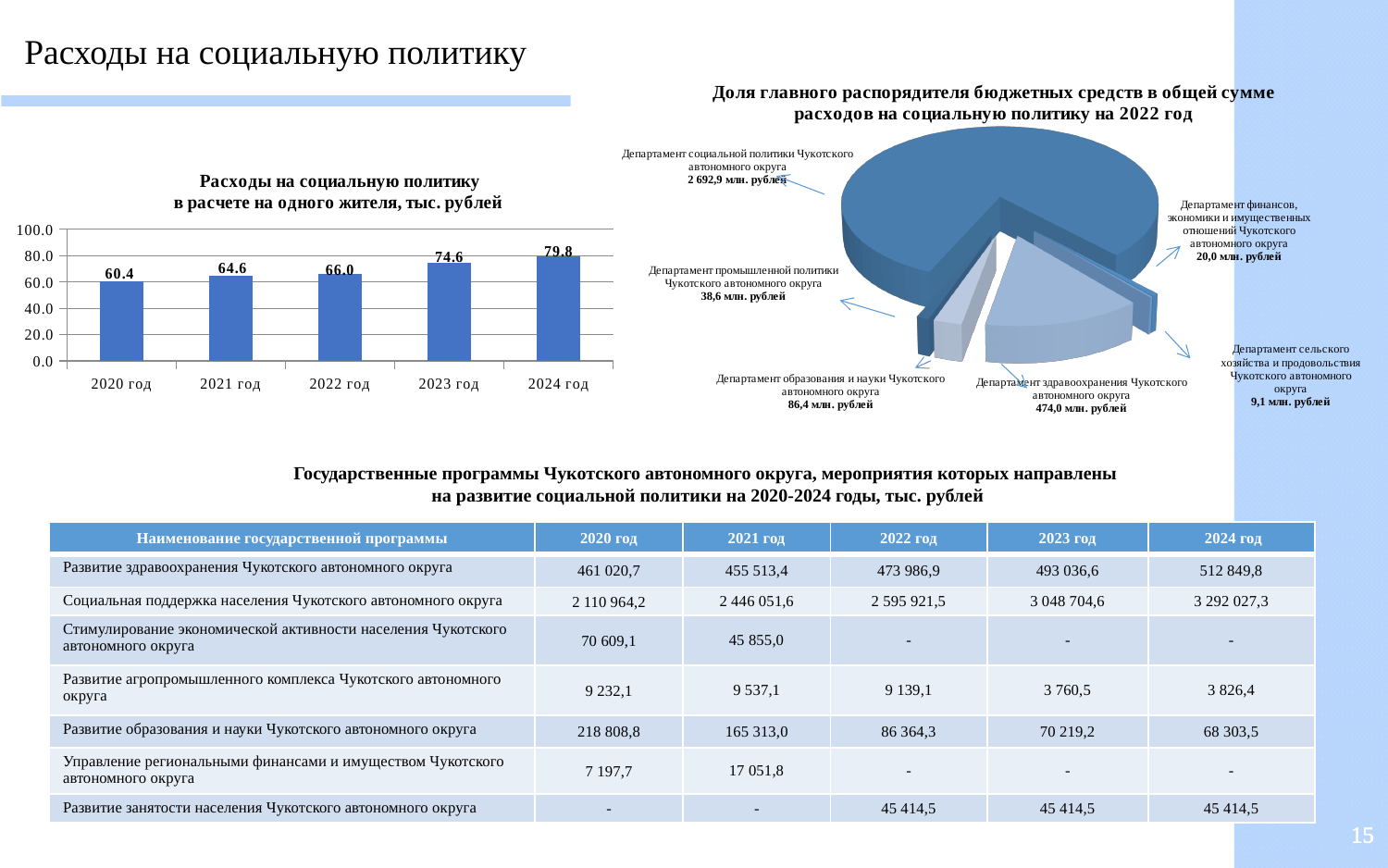
On the bar chart 'Расходы на социальную политику в расчете на одного жителя', how many years are shown? 5 On the bar chart 'Расходы на социальную политику в расчете на одного жителя', what is the value for 2022 год? 66.0 On the bar chart 'Расходы на социальную политику в расчете на одного жителя', do the values rise or fall from 2020 год to 2024 год? rise On the bar chart 'Расходы на социальную политику в расчете на одного жителя', what is the difference between the values for 2023 год and 2020 год? 14.2 On the pie chart 'Доля главного распорядителя бюджетных средств...', which department has the largest value? Департамент социальной политики Чукотского автономного округа On the bar chart 'Расходы на социальную политику в расчете на одного жителя', which year has the highest value? 2024 год What kind of chart is 'Расходы на социальную политику в расчете на одного жителя'? bar chart On the bar chart 'Расходы на социальную политику в расчете на одного жителя', which year has the lowest value? 2020 год On the pie chart 'Доля главного распорядителя бюджетных средств...', what is the value for Департамент сельского хозяйства и продовольствия Чукотского автономного округа? 9,1 млн. рублей On the pie chart 'Доля главного распорядителя бюджетных средств...', what is the value for Департамент здравоохранения Чукотского автономного округа? 474,0 млн. рублей On the pie chart 'Доля главного распорядителя бюджетных средств...', which is larger: Департамент образования и науки or Департамент промышленной политики? Департамент образования и науки On the bar chart 'Расходы на социальную политику в расчете на одного жителя', what is the value for 2024 год? 79.8